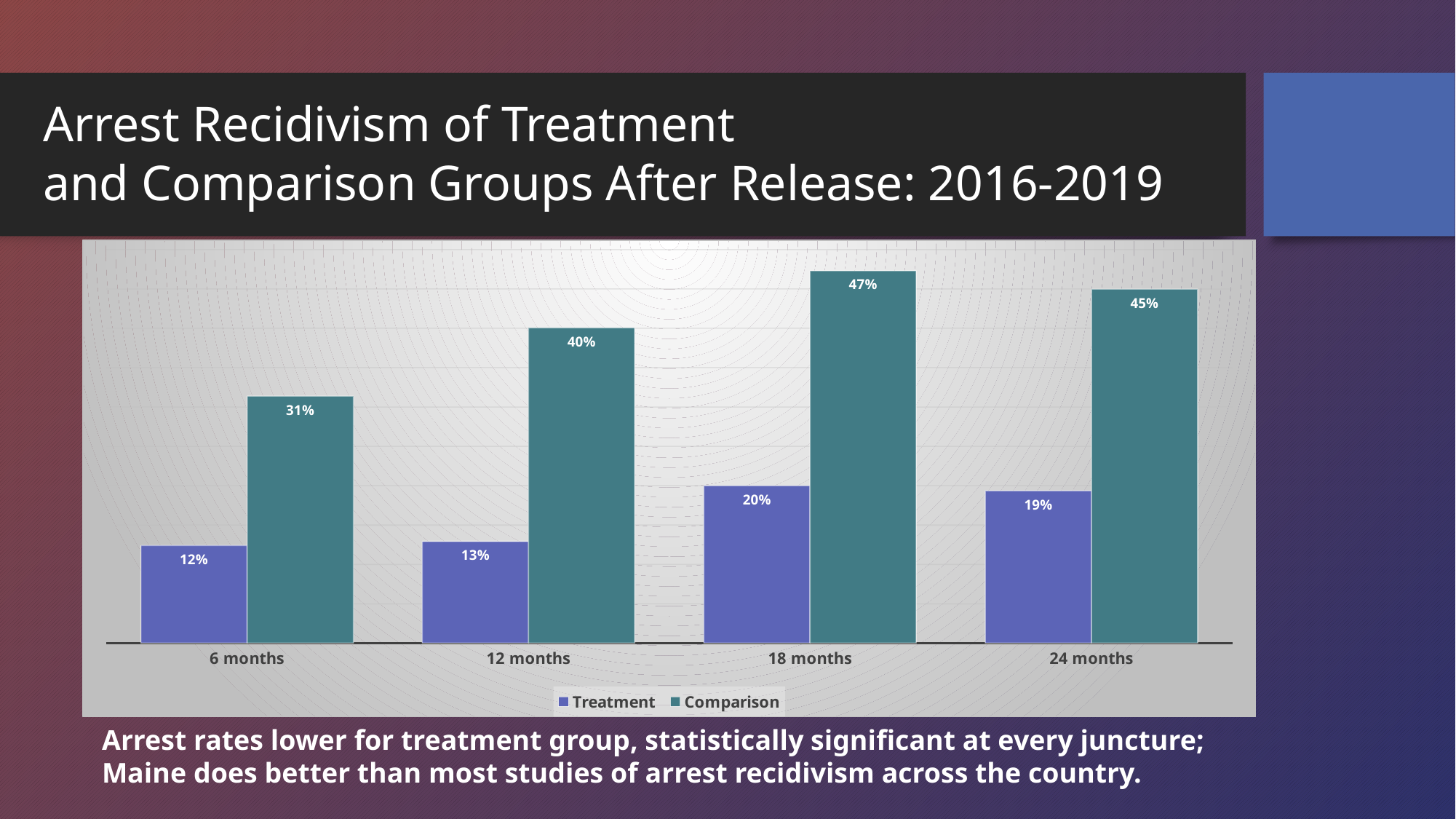
What is the difference between the Comparison and Treatment rates at 12 months? 27% Which is larger at 24 months, the Treatment rate or the Comparison rate? Comparison What is the Comparison group's value at 24 months? 45% How many time points are shown on the x axis? 4 What kind of chart is shown on the slide? Bar chart Which series is shown in teal in the legend? Comparison What is the Treatment group's arrest recidivism rate at 6 months? 12% What is the Comparison group's arrest recidivism rate at 18 months? 47% How many series does the legend list? 2 At which time point is the Comparison group's rate highest? 18 months Does the Comparison group's rate rise or fall from 6 months to 18 months? Rise At which time point is the Treatment group's rate lowest? 6 months